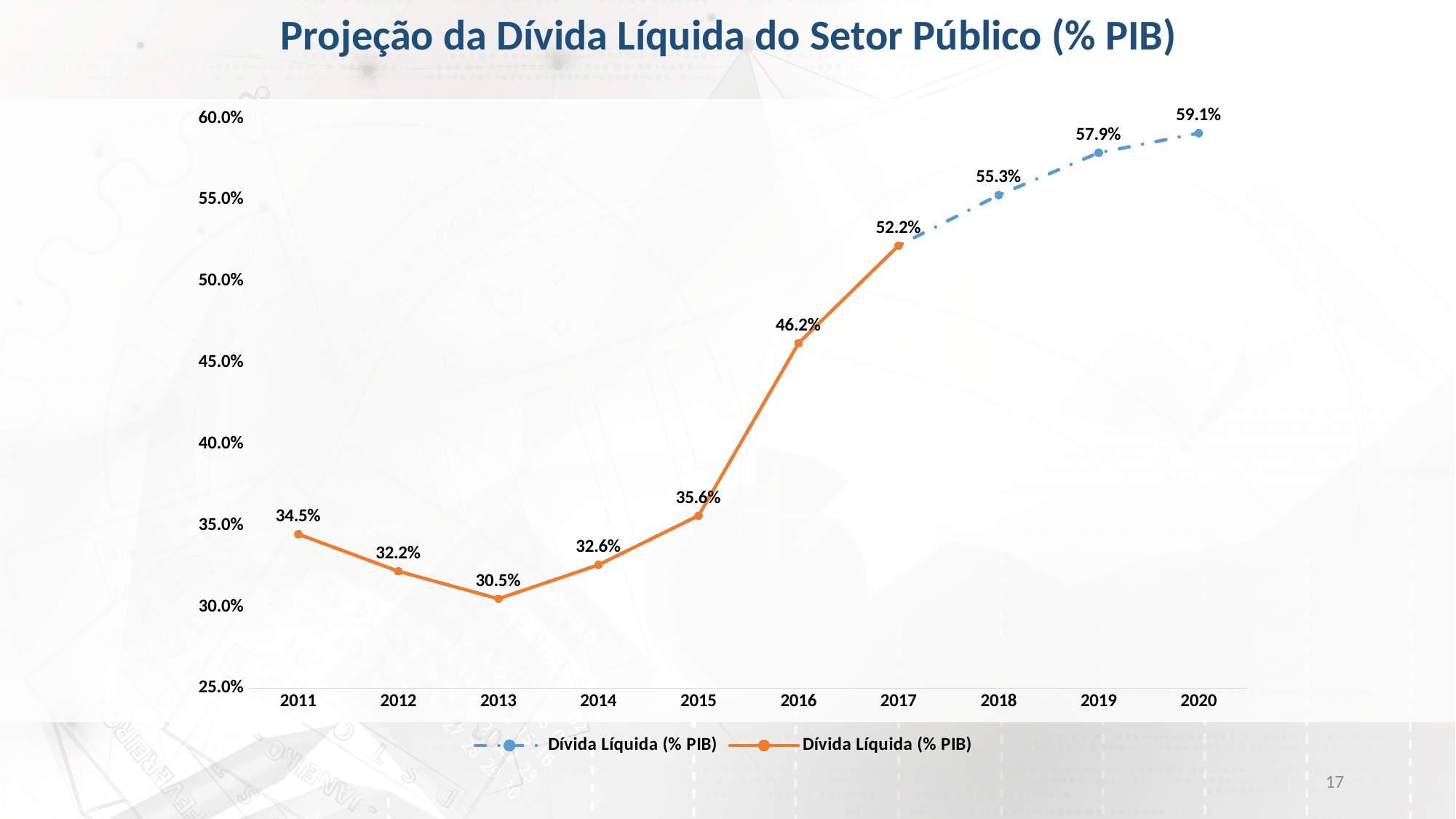
What is the value for 2017? 52.2% Which is larger, the value for 2011 or the value for 2014? 2011 Which year has the highest value? 2020 What is the difference between the values for 2020 and 2011? 24.6% What is the difference between the values for 2017 and 2016? 6.0% What is the projected value for 2020? 59.1% What is the value for 2013? 30.5% What kind of chart is shown? line chart Is the value for 2018 greater or less than 55.0%? greater How many years are shown on the x axis? 10 Which year has the lowest value? 2013 How many series does the legend list? 2